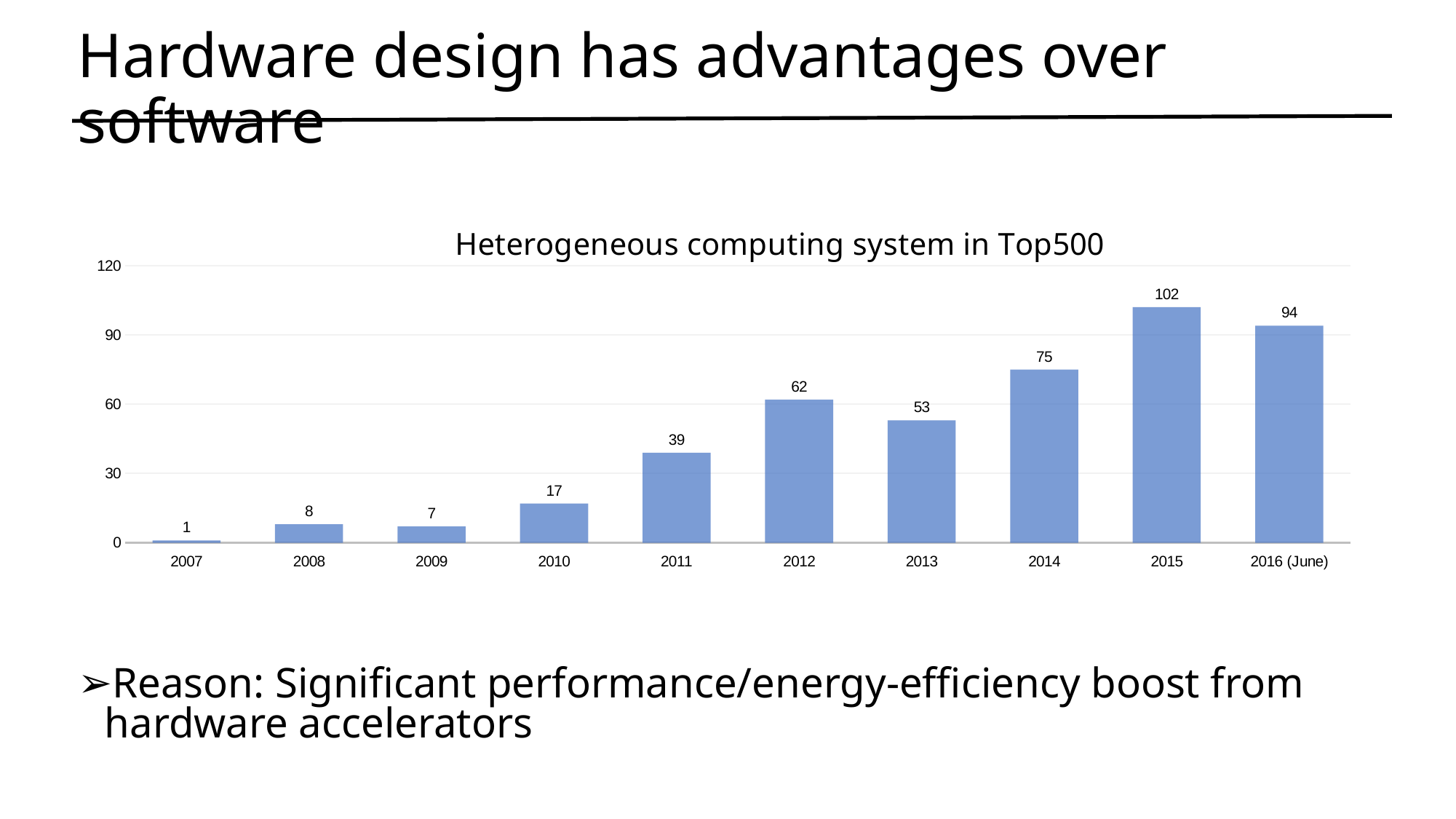
Is the value for 2011 greater or less than 30? greater What is the difference between the values for 2014 and 2013? 22 What kind of chart is shown on the slide? bar chart What is the value for 2012? 62 What is the difference between the values for 2015 and 2016 (June)? 8 What is the value for 2016 (June)? 94 Which year has the highest value? 2015 What is the title of the chart? Heterogeneous computing system in Top500 Which is larger, the value for 2012 or the value for 2013? 2012 Which year has the lowest value? 2007 What is the value for 2009? 7 How many years are shown on the x axis? 10